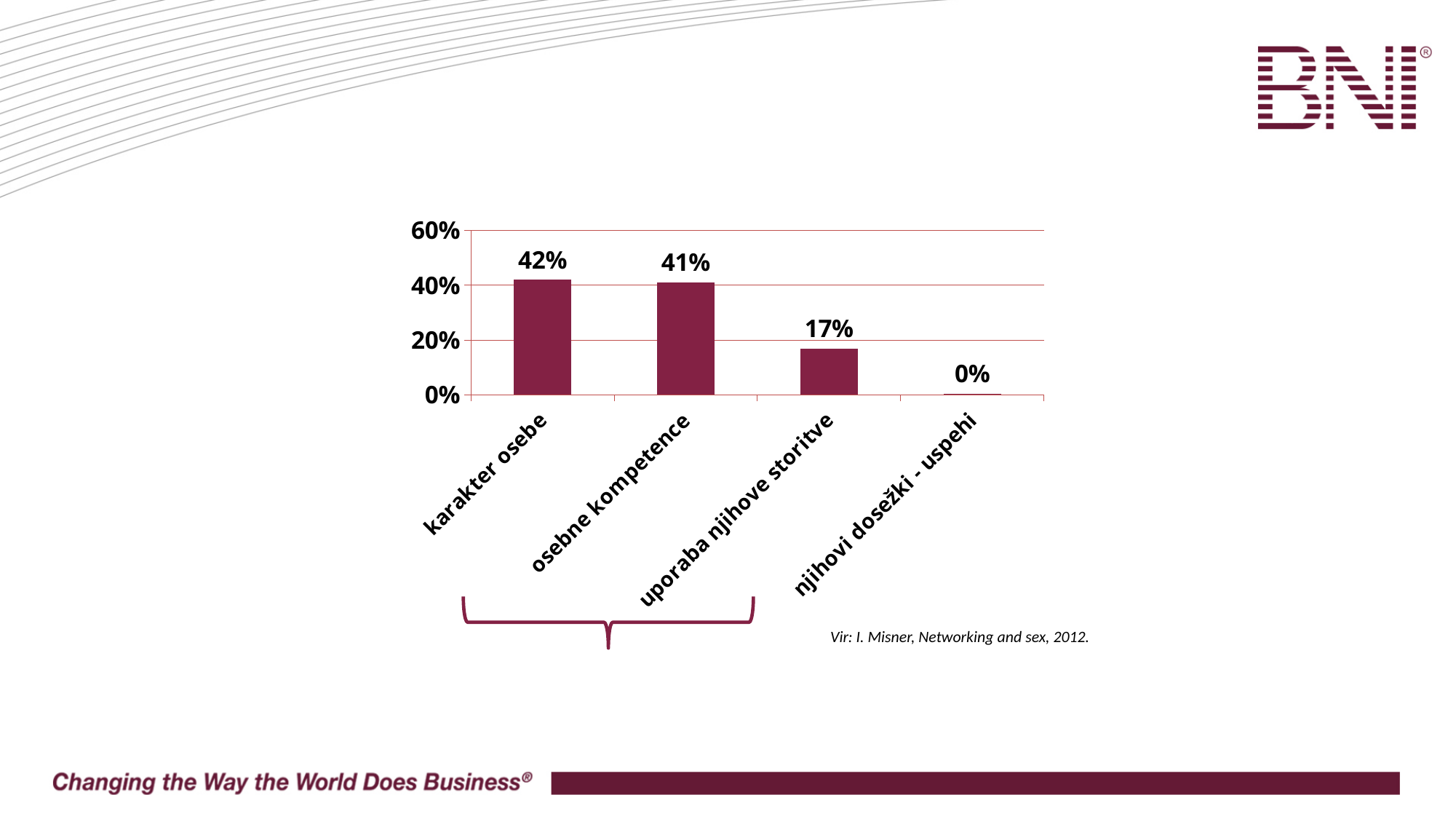
What is the value for "karakter osebe"? 42% How many categories are shown on the x axis? 4 What is the value for "osebne kompetence"? 41% What is the value for "uporaba njihove storitve"? 17% What is the value for "njihovi dosežki - uspehi"? 0% Do the values rise or fall from left to right along the x axis? fall What kind of chart is shown on the slide? bar chart Which category has the highest value? karakter osebe What is the difference between the values for "karakter osebe" and "uporaba njihove storitve"? 25% Which is larger, the value for "osebne kompetence" or the value for "uporaba njihove storitve"? osebne kompetence Is the value for "uporaba njihove storitve" greater or less than 20%? less Which category has the lowest value? njihovi dosežki - uspehi